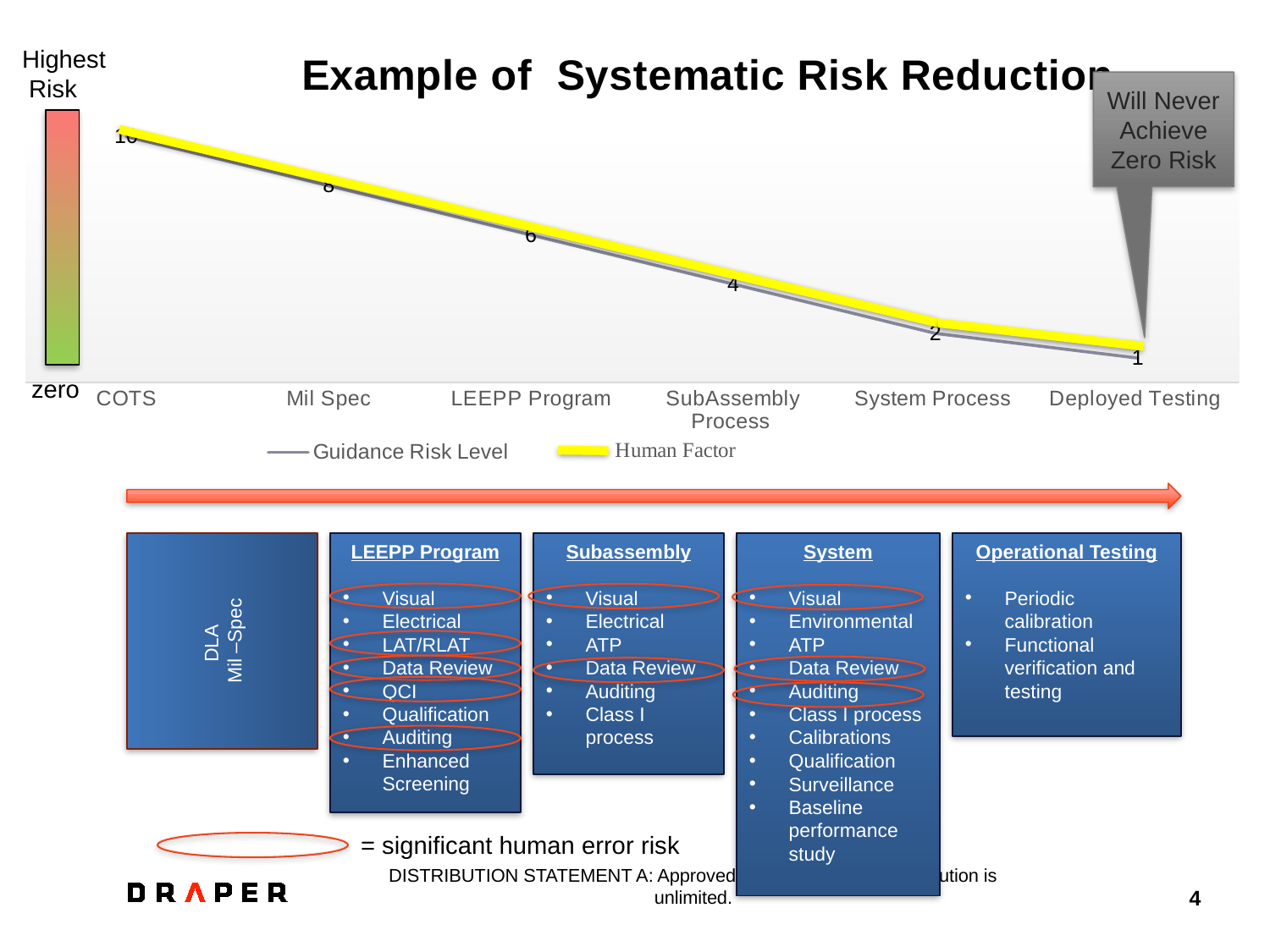
What are the two series named in the chart legend? Guidance Risk Level and Human Factor What is the Guidance Risk Level value for SubAssembly Process? 4 Do the Guidance Risk Level values rise or fall from COTS to Deployed Testing? fall What is the Guidance Risk Level value for Deployed Testing? 1 What is the Guidance Risk Level value for Mil Spec? 8 How many series does the chart legend list? 2 Which category has the highest Guidance Risk Level? COTS What type of chart is shown on the slide? line chart How many categories are shown along the x axis of the chart? 6 What is the Guidance Risk Level value for LEEPP Program? 6 Which category has the lowest Guidance Risk Level? Deployed Testing What is the difference between the Guidance Risk Level for Mil Spec and for System Process? 6